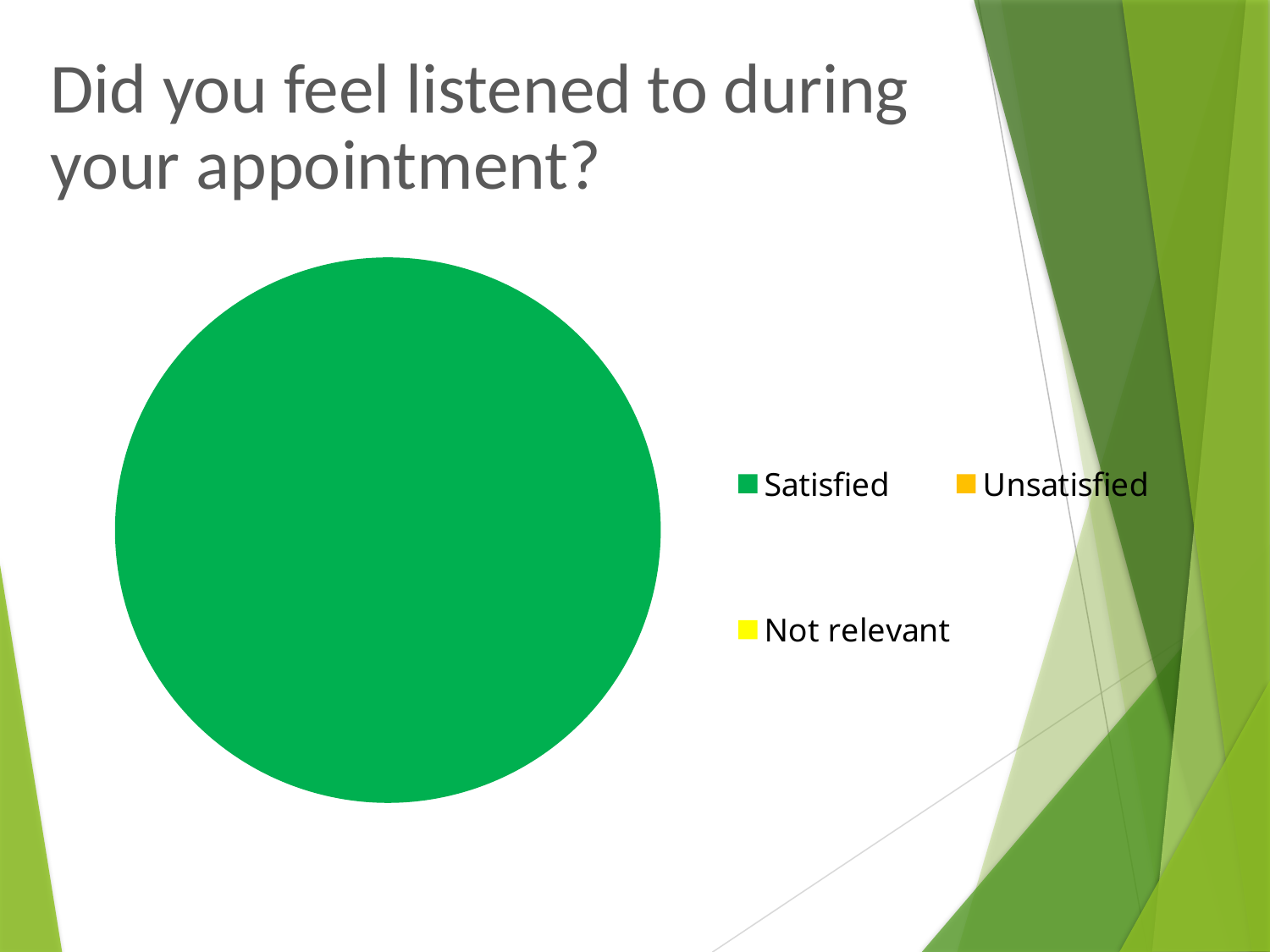
What is the title of the chart on the slide? Did you feel listened to during your appointment? How many categories does the legend of the pie chart list? 3 Which is larger in the pie chart, Satisfied or Not relevant? Satisfied Which is larger in the pie chart, Satisfied or Unsatisfied? Satisfied Which legend entries are listed in the pie chart? Satisfied, Unsatisfied, Not relevant What kind of chart is shown on the slide? Pie chart What colour represents the Satisfied category in the pie chart? Green Which category takes up the largest share of the pie chart? Satisfied